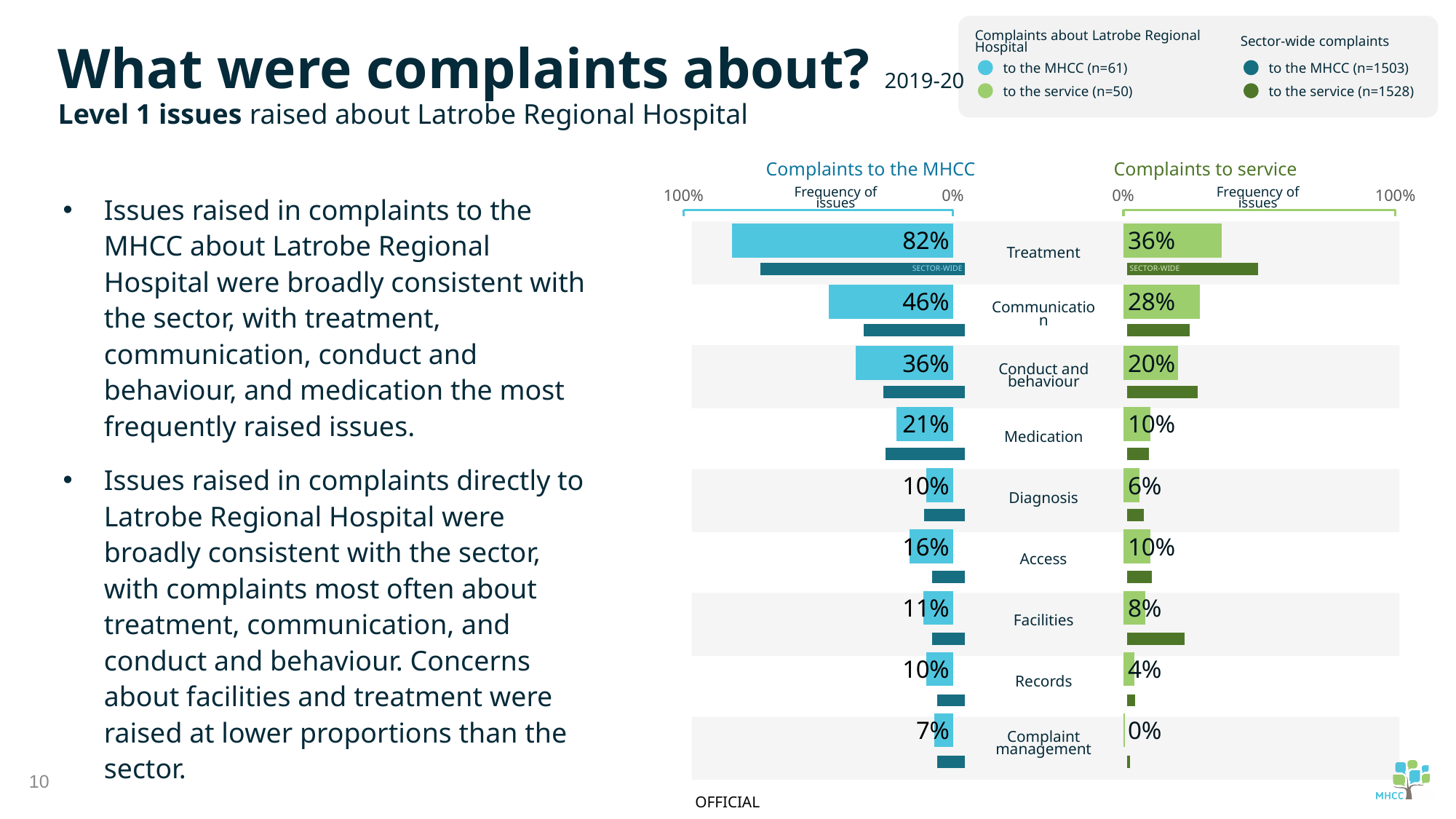
In the 'Complaints to service' chart, what percentage of complaints raised Records? 4% In the 'Complaints to service' chart, what percentage of complaints raised Communication? 28% What type of chart is used to show the frequency of issues in the 'Complaints to service' chart? Bar chart In the 'Complaints to the MHCC' chart, what is the difference between the Treatment and Communication percentages for Latrobe Regional Hospital? 36% How many issue categories are listed in the 'Complaints to the MHCC' chart? 9 In the 'Complaints to service' chart, which issue has the lowest frequency for Latrobe Regional Hospital? Complaint management Which is larger for Latrobe Regional Hospital: the Medication percentage in the 'Complaints to the MHCC' chart or the Medication percentage in the 'Complaints to service' chart? Complaints to the MHCC In the 'Complaints to the MHCC' chart, what percentage of complaints about Latrobe Regional Hospital raised Treatment? 82% In the 'Complaints to service' chart, what is the difference between the Treatment and Conduct and behaviour percentages? 16% In the 'Complaints to the MHCC' chart, which is larger for Latrobe Regional Hospital: Access or Facilities? Access According to the legend, how many complaints about Latrobe Regional Hospital were made to the MHCC? n=61 In the 'Complaints to the MHCC' chart, which issue has the highest frequency for Latrobe Regional Hospital? Treatment